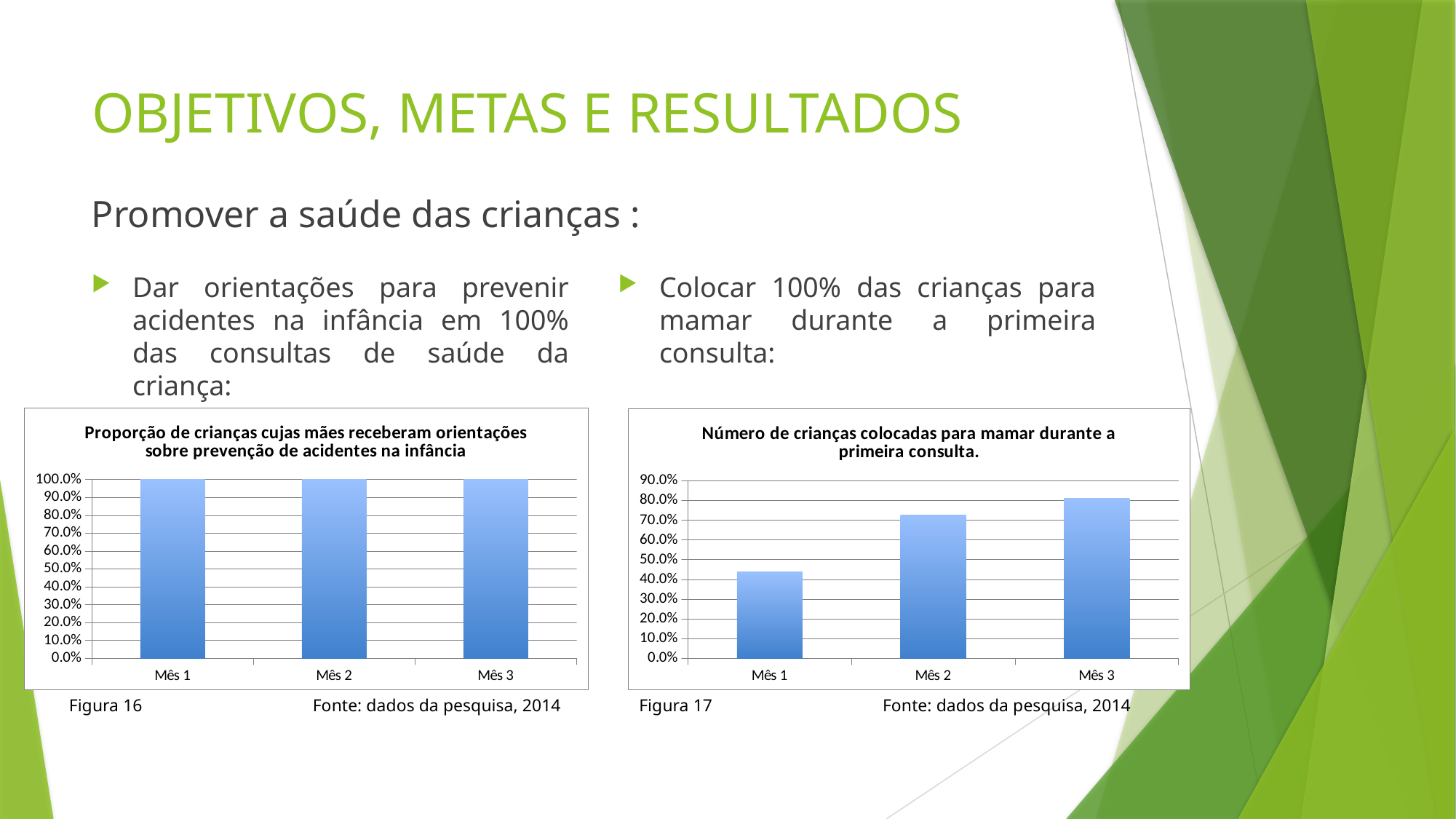
In the left chart (Figura 16), what is the value for Mês 1? 100.0% In the right chart (Figura 17), which is larger, the value for Mês 2 or Mês 1? Mês 2 In the right chart (Figura 17), is the value for Mês 2 greater or less than 60.0%? greater In the left chart (Figura 16), how many categories are shown on the x axis? 3 What is the title of the right chart (Figura 17)? Número de crianças colocadas para mamar durante a primeira consulta. In the left chart (Figura 16), what is the value for Mês 3? 100.0% In the right chart (Figura 17), is the value for Mês 1 greater or less than 50.0%? less In the right chart (Figura 17), do the values rise or fall from Mês 1 to Mês 3? rise What kind of chart is the right chart (Figura 17)? bar chart In the right chart (Figura 17), which month has the highest value? Mês 3 In the right chart (Figura 17), which month has the lowest value? Mês 1